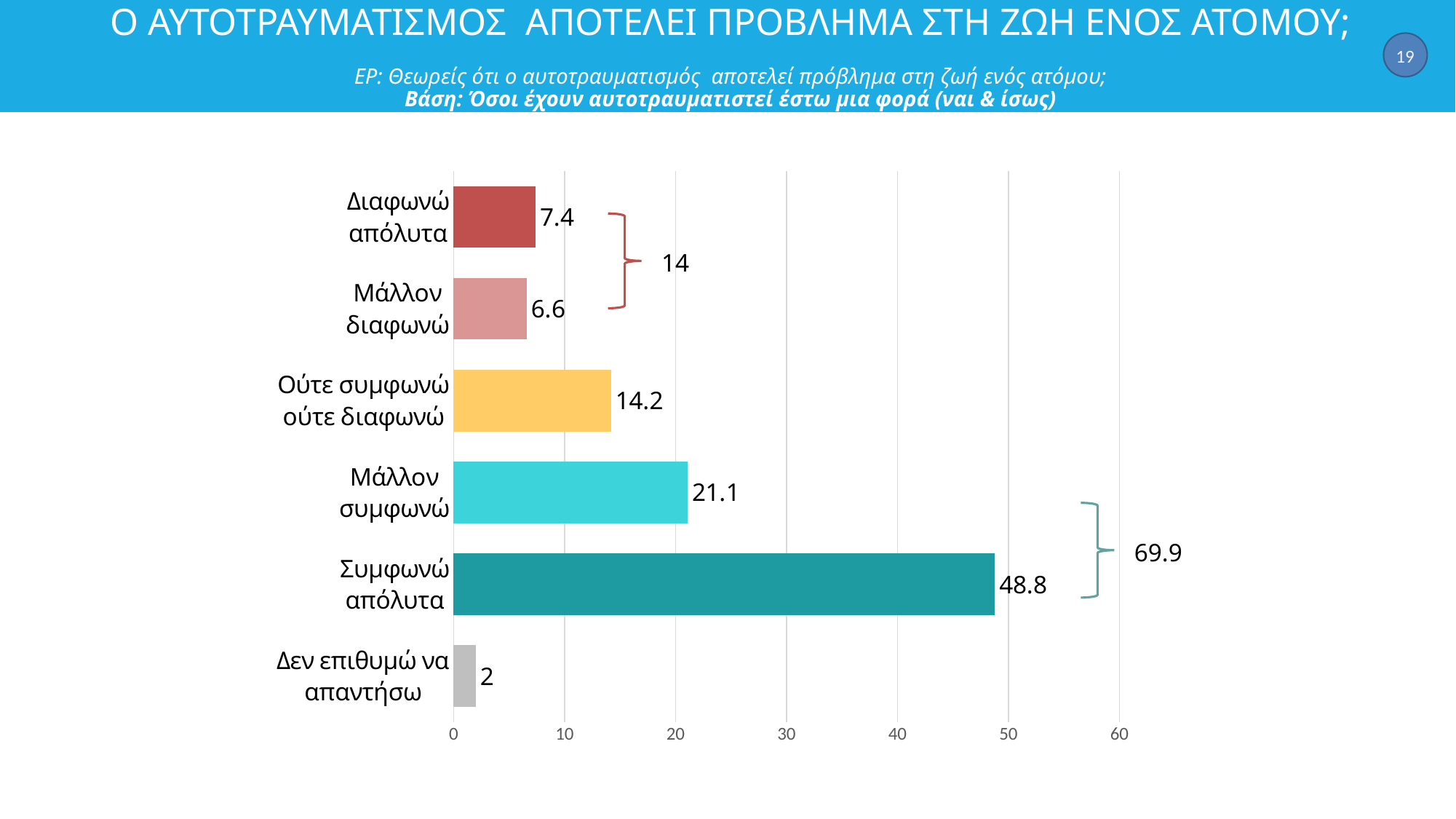
What combined value is shown by the bracket grouping Μάλλον συμφωνώ and Συμφωνώ απόλυτα? 69.9 What is the value for Δεν επιθυμώ να απαντήσω? 2 What is the value for Συμφωνώ απόλυτα? 48.8 How many categories are shown in the chart? 6 Which is larger, the value for Διαφωνώ απόλυτα or the value for Μάλλον διαφωνώ? Διαφωνώ απόλυτα Which category has the highest value? Συμφωνώ απόλυτα What is the value for Μάλλον διαφωνώ? 6.6 Is the value for Μάλλον συμφωνώ greater or less than 30? less What is the difference between the values for Συμφωνώ απόλυτα and Μάλλον συμφωνώ? 27.7 Which category has the lowest value? Δεν επιθυμώ να απαντήσω What is the value for Ούτε συμφωνώ ούτε διαφωνώ? 14.2 What kind of chart is shown on the slide? bar chart